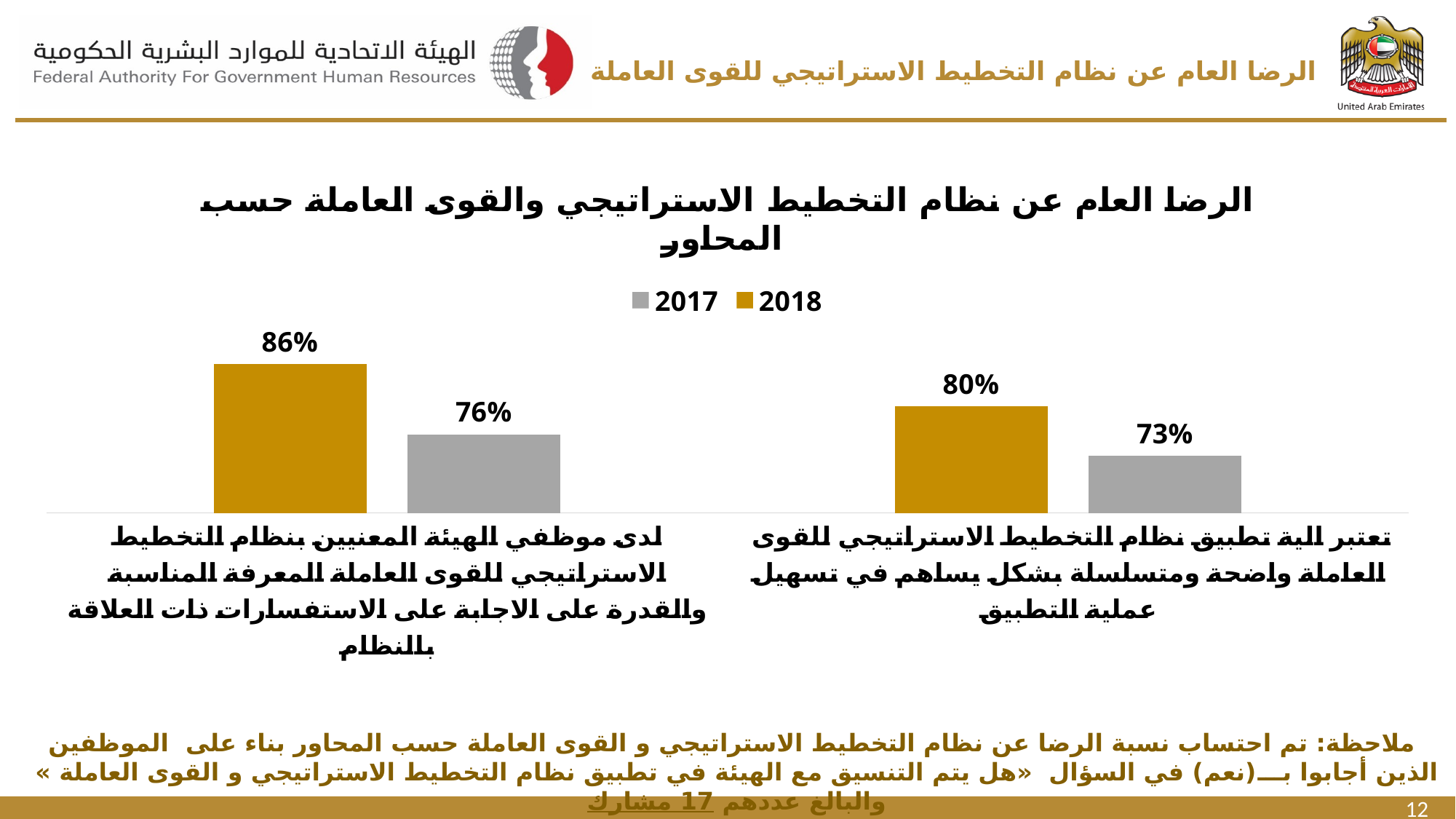
Which bar in the chart has the lowest value? 2017 for the right category (تعتبر الية تطبيق...), 73% How many series does the chart legend list? 2 What is the 2017 value for the left category (لدى موظفي الهيئة المعنيين...)? 76% What type of chart is shown on the slide? Bar chart What is the 2018 value for the left category (employees having appropriate knowledge of the system, لدى موظفي الهيئة المعنيين...)? 86% What is the 2018 value for the right category (the application mechanism is clear and sequential, تعتبر الية تطبيق...)? 80% How many categories (axes/محاور) are plotted in the chart? 2 Which colour represents the 2018 series in the chart? Gold (dark yellow) What is the 2017 value for the right category (تعتبر الية تطبيق...)? 73% Which bar in the chart has the highest value? 2018 for the left category (لدى موظفي الهيئة المعنيين...), 86% Which years are listed in the chart legend? 2017 and 2018 What is the difference between the 2018 and 2017 values for the left category (لدى موظفي الهيئة المعنيين...)? 10%